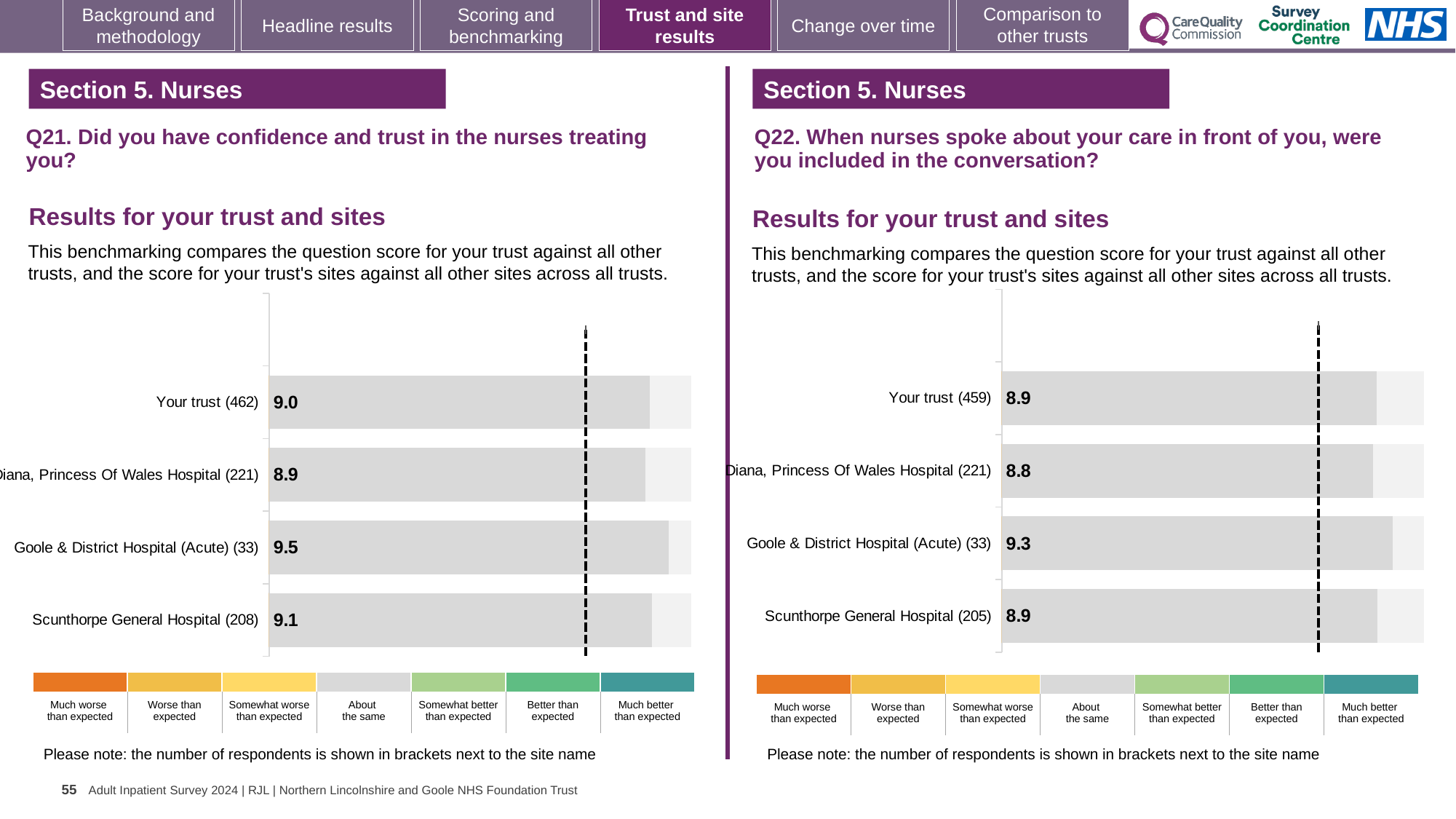
In the Q21 chart on the left, what is the score for Your trust (462)? 9.0 In the Q21 chart on the left, how many respondents are shown in brackets for Your trust? 462 In the Q22 chart on the right, which has the higher score: Your trust or Diana, Princess Of Wales Hospital? Your trust What type of chart is used for the Q22 results on the right? Bar chart In the Q21 chart on the left, which site has the lowest score? Diana, Princess Of Wales Hospital (221) In the Q22 chart on the right, what is the difference between the scores for Goole & District Hospital (Acute) and Your trust? 0.4 In the Q22 chart on the right, what is the score for Scunthorpe General Hospital (205)? 8.9 In the Q21 chart on the left, what is the difference between the scores for Goole & District Hospital (Acute) and Scunthorpe General Hospital? 0.4 In the Q22 chart on the right, which site has the highest score? Goole & District Hospital (Acute) (33) In the Q21 chart on the left, what is the score for Goole & District Hospital (Acute) (33)? 9.5 How many bars are shown in the Q21 chart on the left? 4 In the Q22 chart on the right, what is the score for Diana, Princess Of Wales Hospital (221)? 8.8